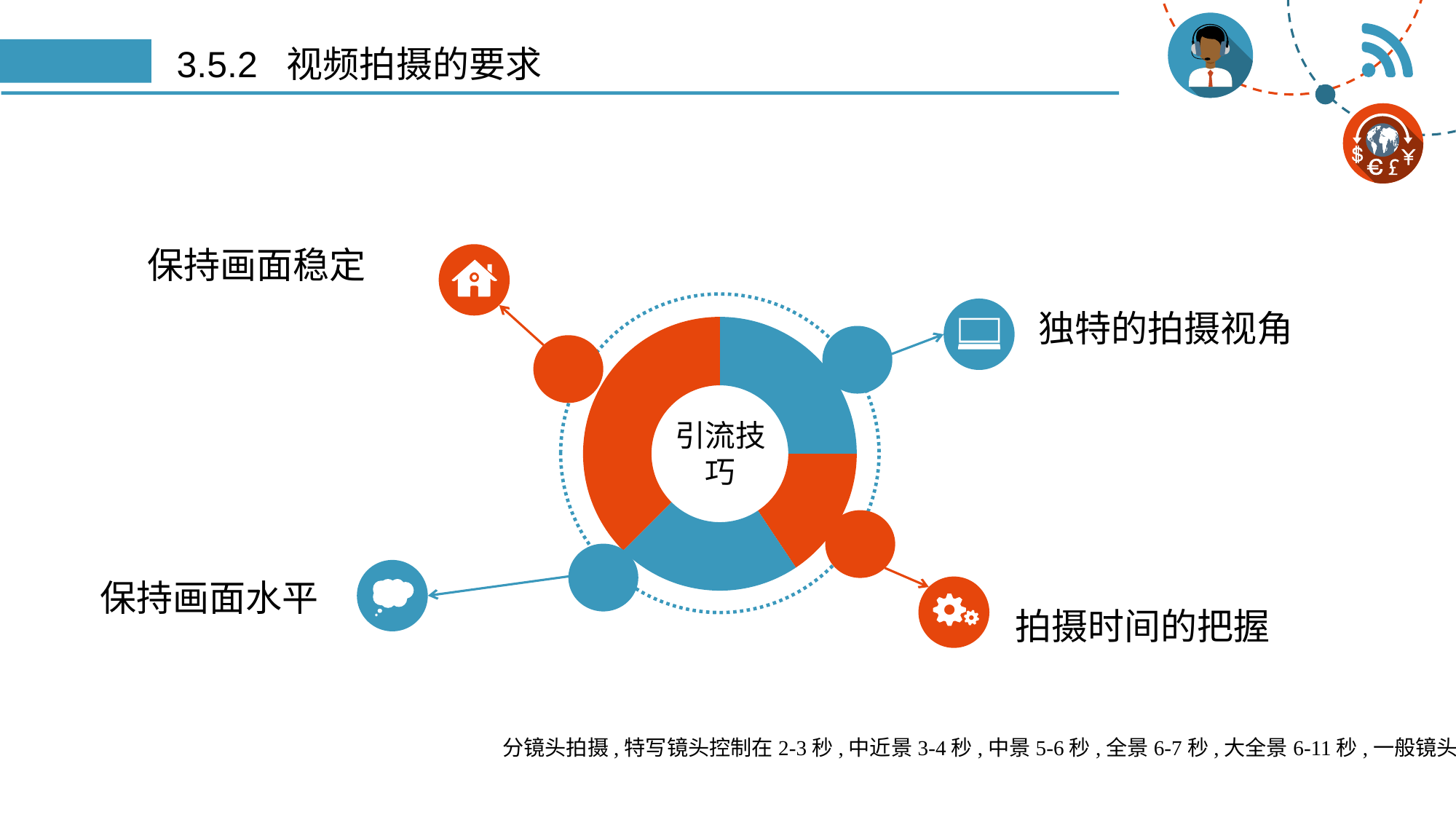
Is the left orange segment of the doughnut chart larger or smaller than the lower-right orange segment? Larger Which segment of the doughnut chart is the largest, by position? The left orange segment Which two colours are used for the segments of the doughnut chart? Orange and blue Which segment of the doughnut chart is the smallest, by position? The lower-right orange segment What text is written in the centre of the doughnut chart? 引流技巧 What kind of chart is shown in the centre of the slide? Doughnut chart How many segments does the doughnut chart have? 4